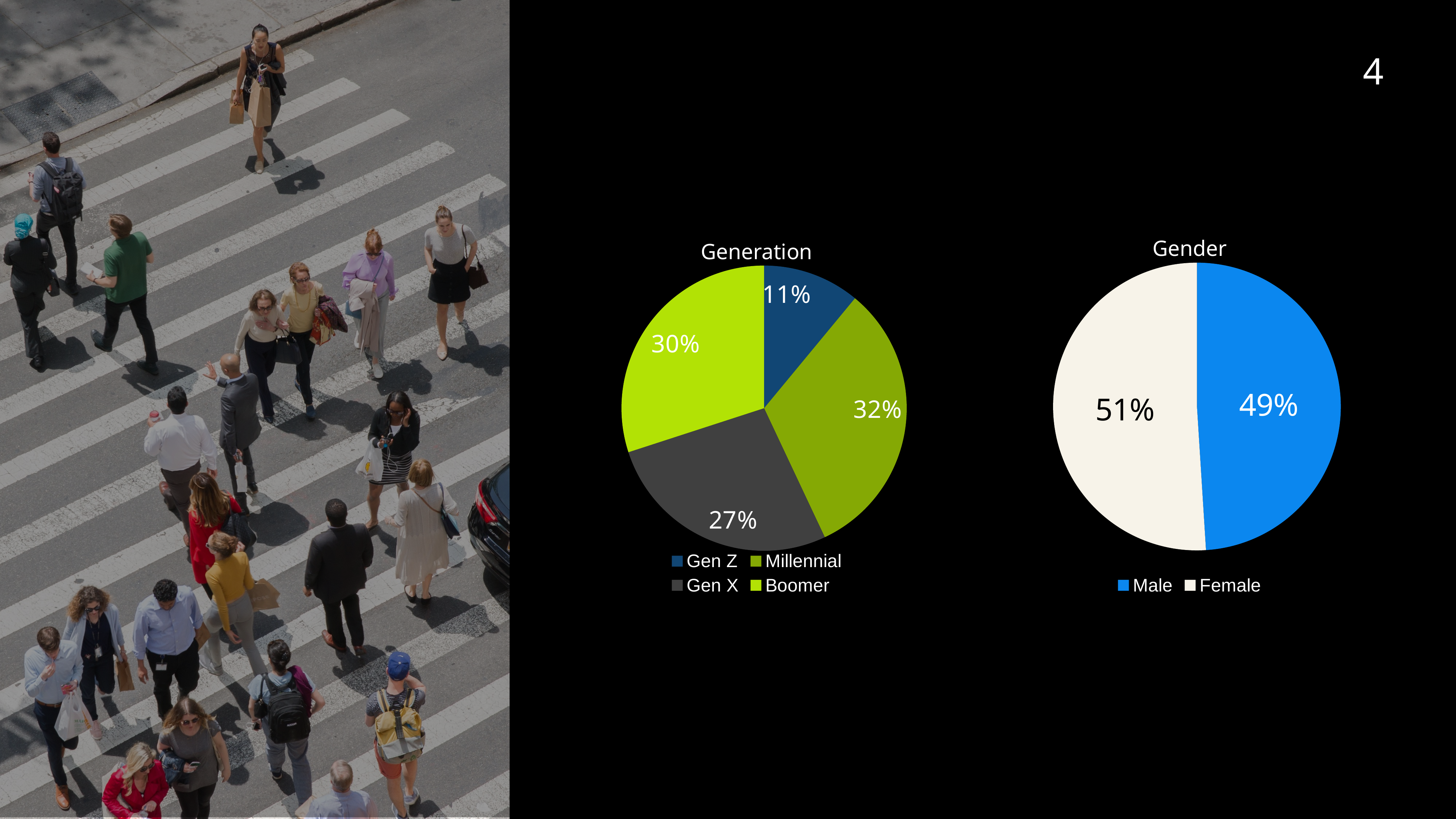
What kind of chart is the Gender chart? Pie chart In the Gender chart, what colour is the Male slice? Blue In the Generation chart, which generation has the largest share? Millennial In the Generation chart, how many slices does the pie have? 4 In the Gender chart, what share is Male? 49% In the Generation chart, what share is Gen Z? 11% In the Generation chart, what is the difference between the Millennial and Gen Z shares? 21% In the Generation chart, what share is Gen X? 27% In the Generation chart, which generation has the smallest share? Gen Z In the Gender chart, what share is Female? 51% In the Generation chart, what share is Boomer? 30% In the Generation chart, what share is Millennial? 32%